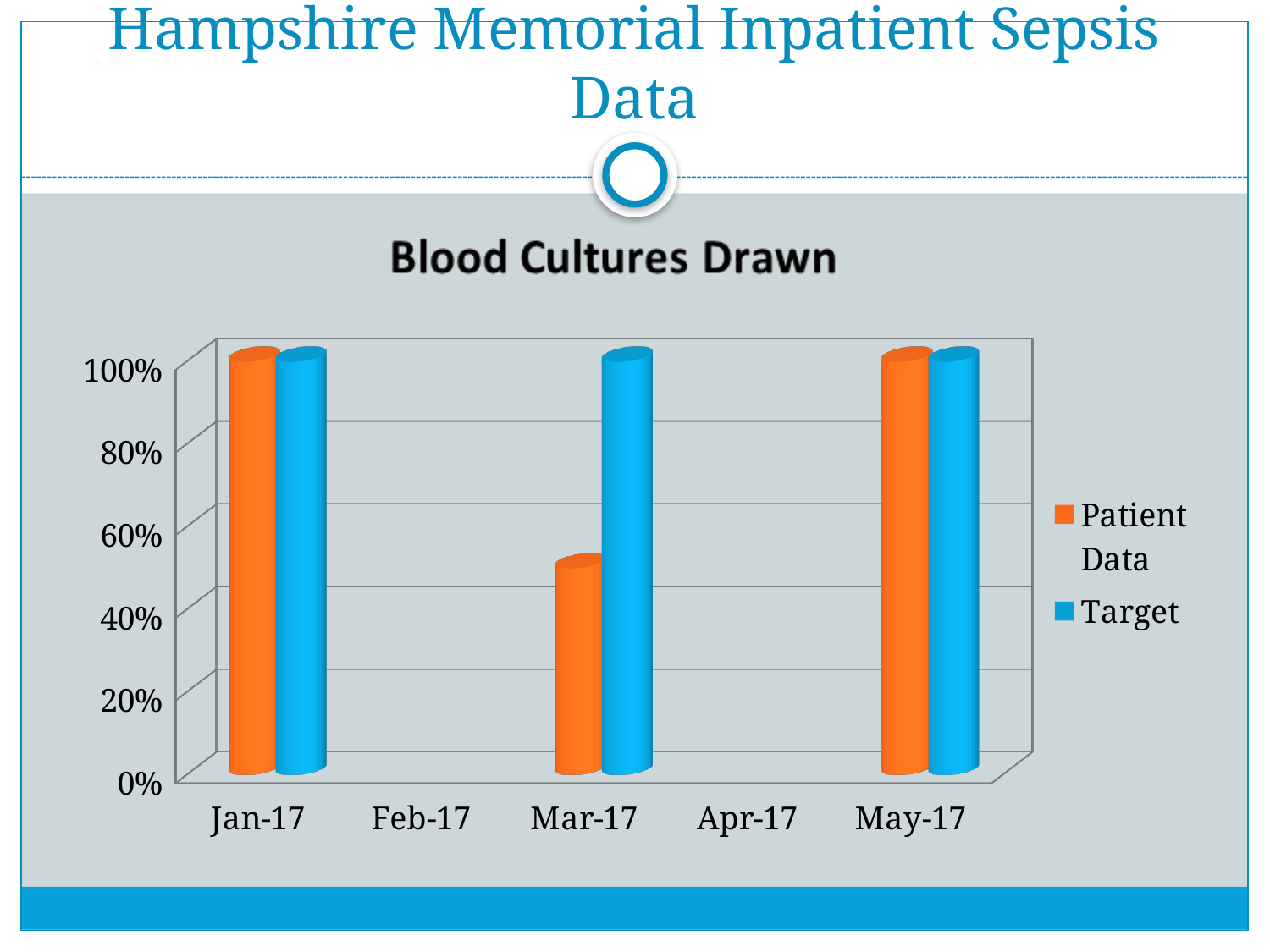
What colour represents the Target series? blue Which month has the lowest Patient Data bar among the months with bars? Mar-17 Is the Patient Data value for Mar-17 greater or less than 60%? less Is the Patient Data value for Mar-17 greater or less than 40%? greater How many month categories are shown on the x axis? 5 What is the Target value for May-17? 100% How many series does the legend list? 2 What is the Target value for Jan-17? 100% What kind of chart is shown on the slide? bar chart What is the Patient Data value for Jan-17? 100% What is the title of the chart? Blood Cultures Drawn For Mar-17, which is larger, Patient Data or Target? Target